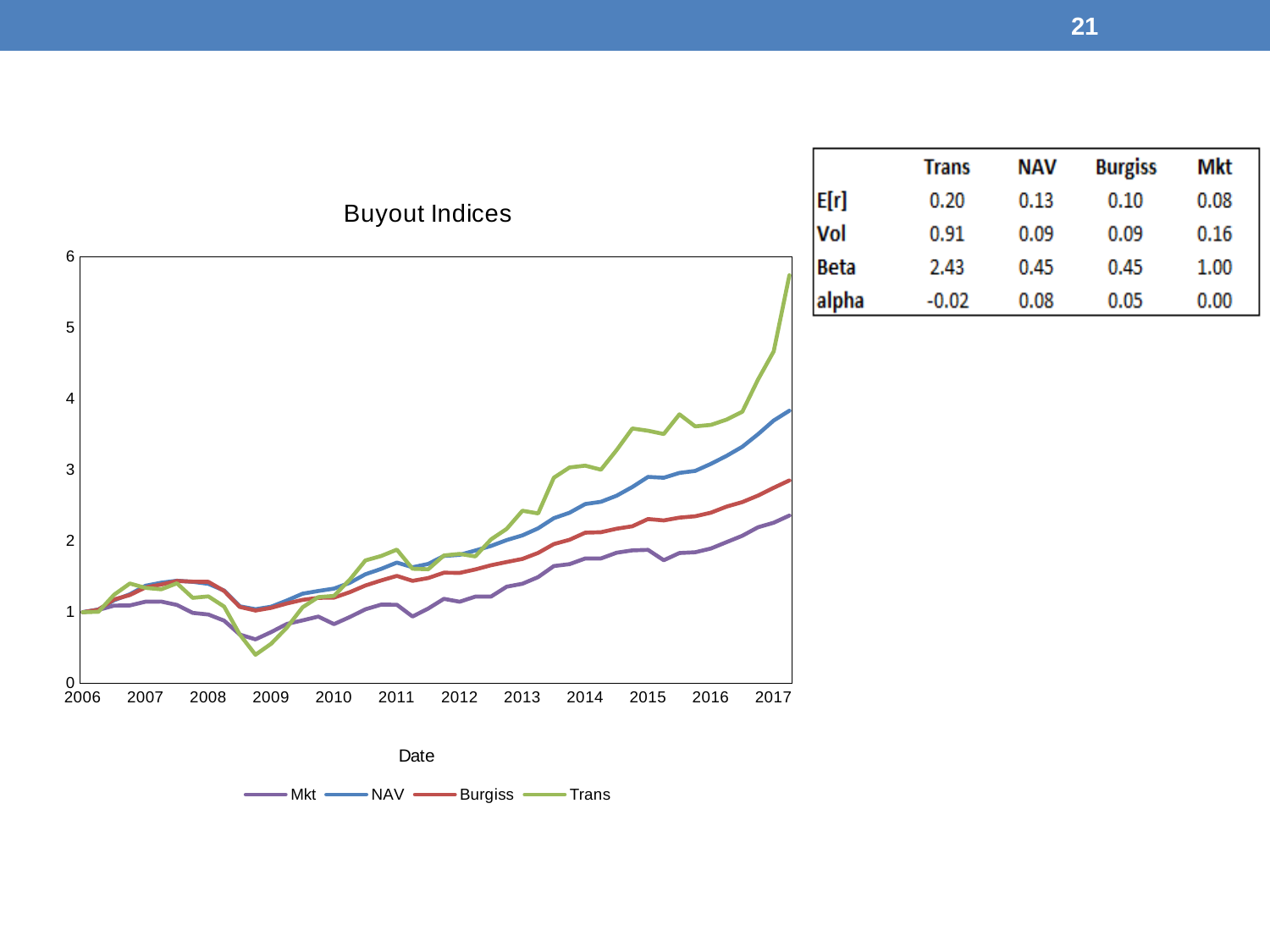
Which series has the lowest value at the end of the Buyout Indices chart in 2017? Mkt At what value do all four series start in 2006? 1 Does the Trans series rise or fall overall from 2006 to 2017? rise Which series has the highest value at the end of the Buyout Indices chart in 2017? Trans What is the title of the chart on the slide? Buyout Indices Is the value of the Mkt series at the end of 2017 greater or less than 3? less What type of chart is shown on the slide? line chart What is the label of the x axis of the Buyout Indices chart? Date Is the value of the Trans series at the end of 2017 greater or less than 5? greater How many series does the legend of the Buyout Indices chart list? 4 Is the lowest value of the Trans series around 2009 greater or less than 1? less At the end of 2017, which series is higher, NAV or Burgiss? NAV